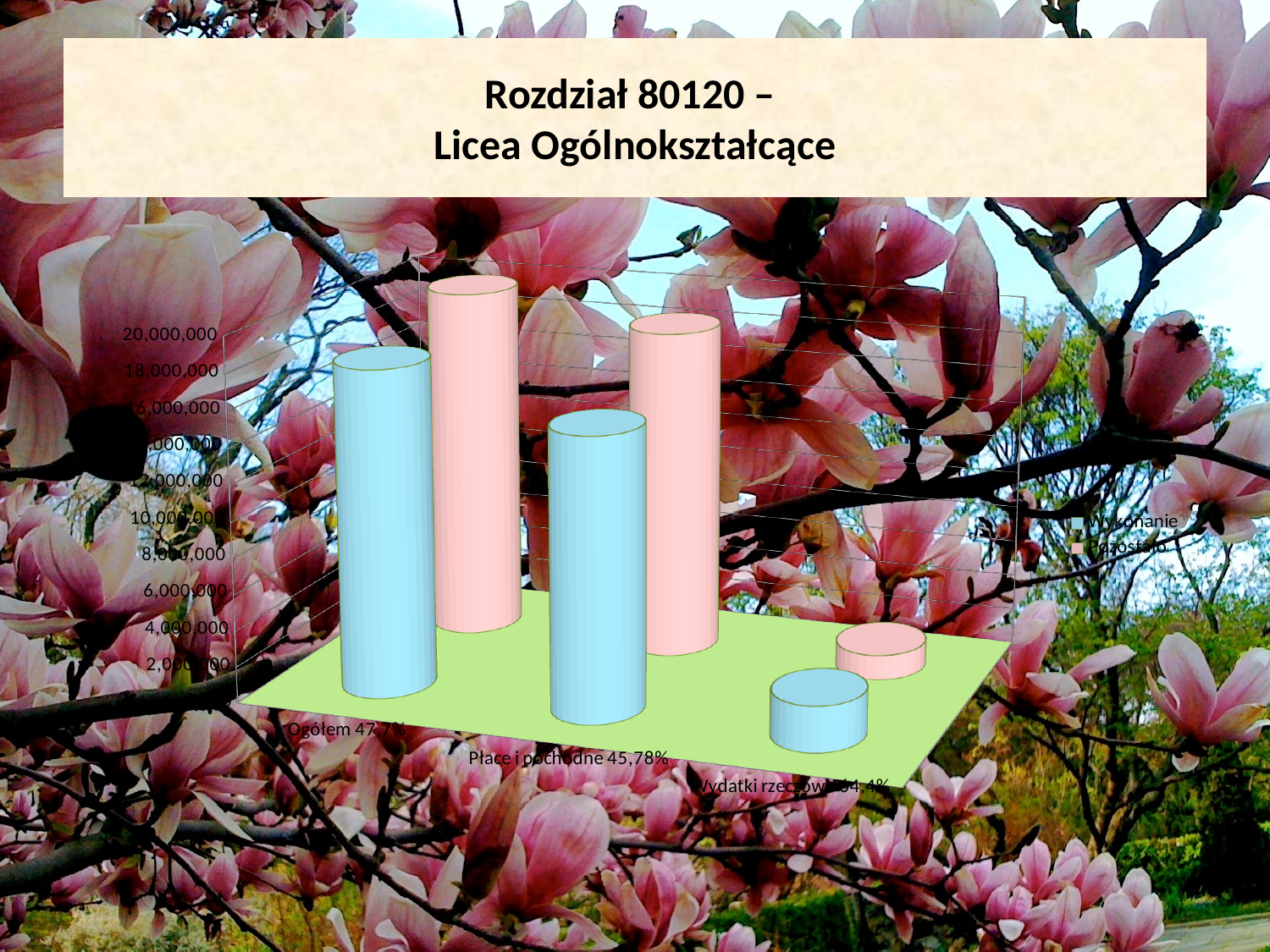
Which Wykonanie bar is taller: Ogółem or Płace i pochodne? Ogółem For Płace i pochodne, which is larger: Wykonanie or Pozostało? Pozostało What is the title of the slide containing the chart? Rozdział 80120 – Licea Ogólnokształcące What are the two series named in the legend? Wykonanie and Pozostało Which category has the tallest Pozostało bar? Ogółem What kind of chart is shown on the slide? bar chart How many series does the chart legend list? 2 Which category has the shortest Wykonanie bar? Wydatki rzeczowe For Ogółem, which is larger: Wykonanie or Pozostało? Pozostało Is the Wykonanie value for Ogółem greater or less than 10,000,000? greater How many categories are plotted on the chart? 3 Is the Wykonanie value for Wydatki rzeczowe greater or less than 6,000,000? less